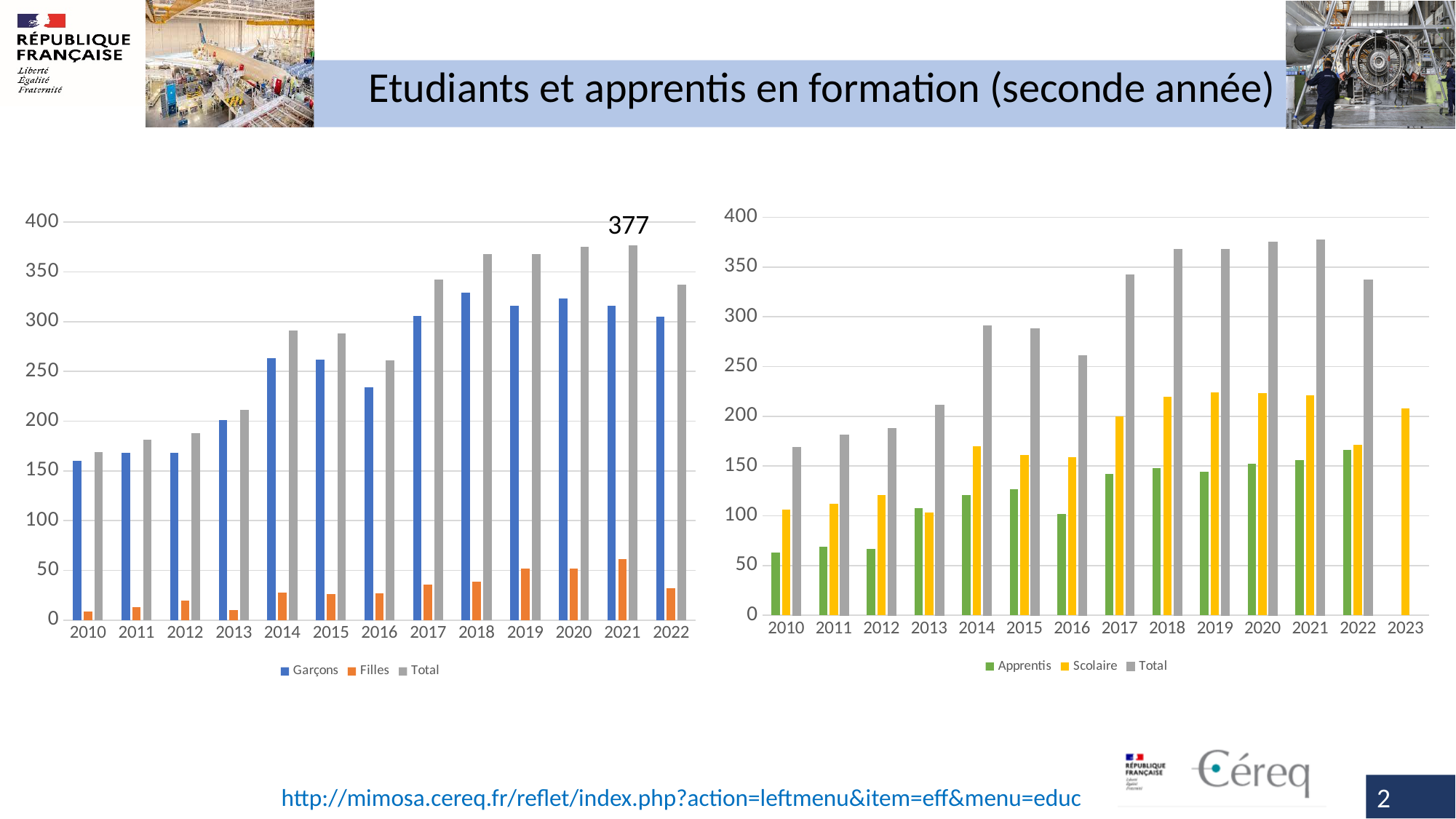
How many years are shown on the x axis of the left chart? 13 In the right chart, is the value for Scolaire in 2023 greater or less than 200? greater In the left chart, is the Garçons value larger in 2017 or in 2018? 2018 In the left chart, is the value for Garçons in 2010 greater or less than 150? greater In the right chart, which is larger in 2016, Apprentis or Scolaire? Scolaire How many series does the legend of the left chart list? 3 In the left chart, is the value for Filles in 2021 greater or less than 50? greater How many years are shown on the x axis of the right chart? 14 In the left chart, which year has the lowest Total? 2010 In the left chart, what is the value of the Total bar for 2021? 377 What are the legend entries of the right chart? Apprentis, Scolaire, Total What kind of chart is the left chart? bar chart